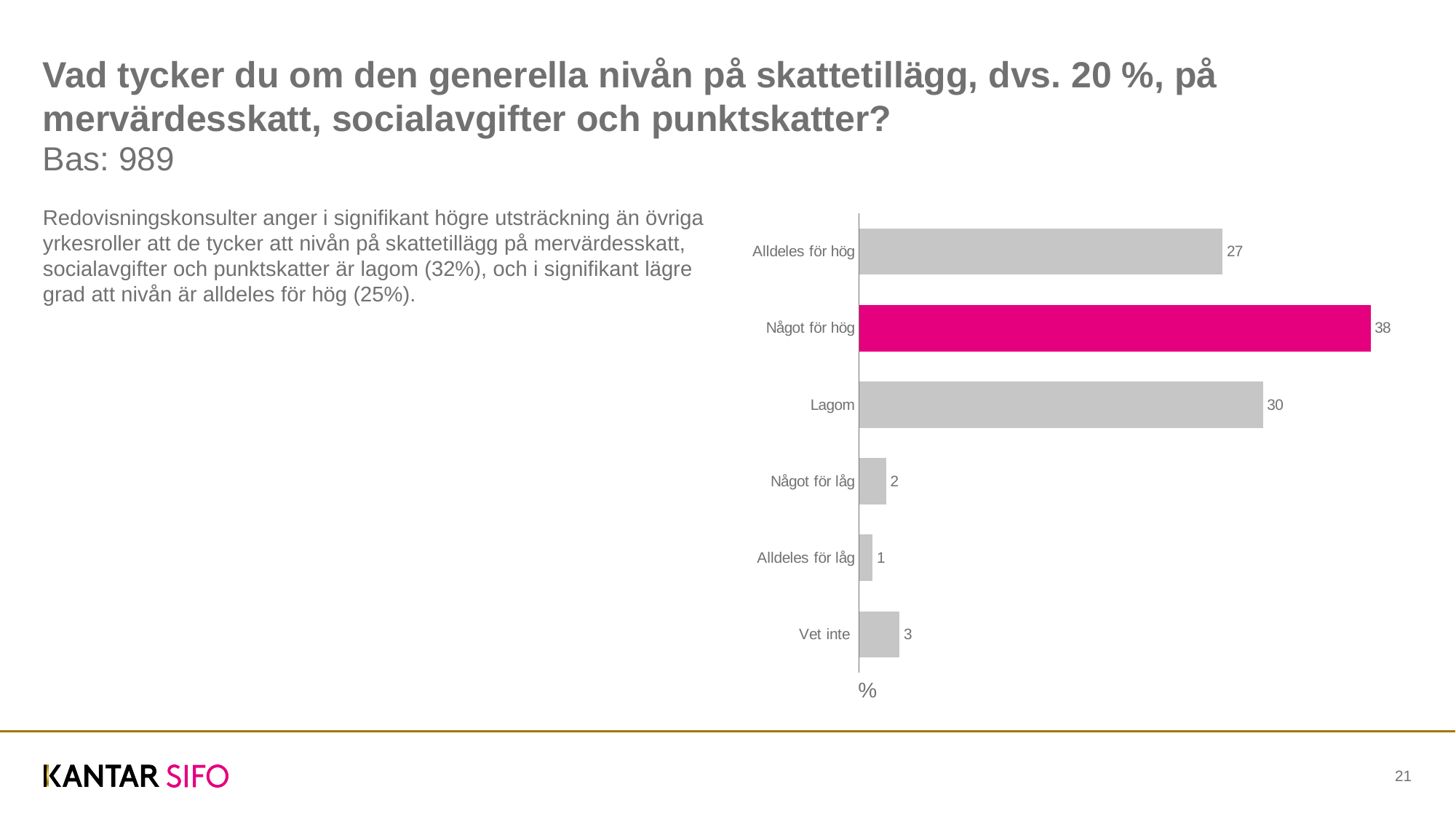
What is the value for "Något för hög"? 38 Which category has the highest value? Något för hög What is the value for "Alldeles för hög"? 27 Which category has the lowest value? Alldeles för låg What kind of chart is shown on the slide? Bar chart How many categories are shown in the chart? 6 What is the value for "Vet inte"? 3 Which bar is highlighted in a different colour (pink) from the others? Något för hög What is the value for "Lagom"? 30 Which is larger, the value for "Lagom" or the value for "Alldeles för hög"? Lagom What is the difference between the values for "Alldeles för hög" and "Något för låg"? 25 What is the difference between the values for "Något för hög" and "Lagom"? 8